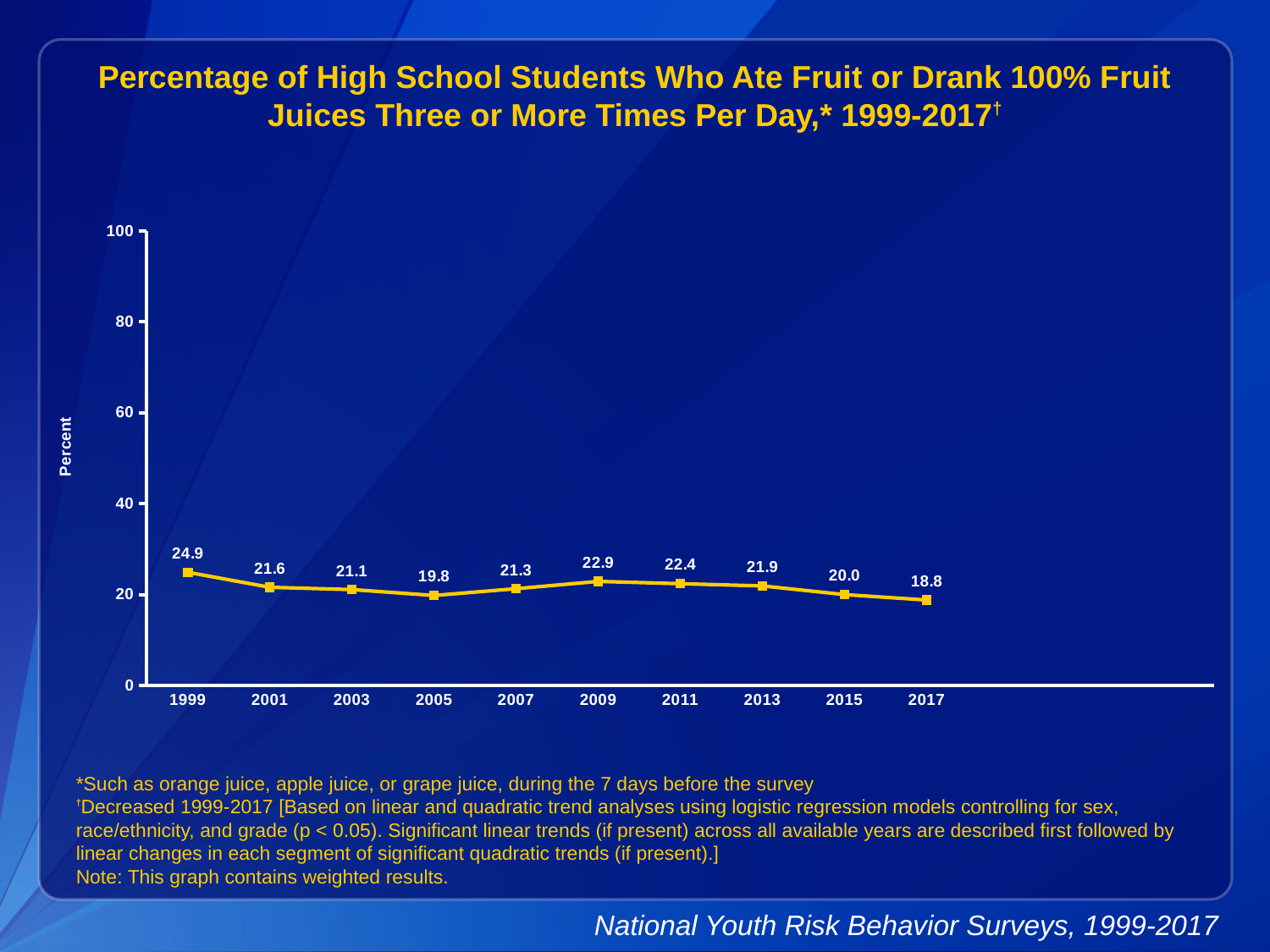
What is the difference between the values for 1999 and 2017? 6.1 Overall, do the values rise or fall from 1999 to 2017? fall What percentage of high school students ate fruit or drank 100% fruit juices three or more times per day in 1999? 24.9 Which year has the lowest value on the chart? 2017 Which year has the highest value on the chart? 1999 What is the label on the vertical axis of the chart? Percent Is the value for 2015 greater or less than 40? less Which year has the larger value, 2005 or 2009? 2009 What kind of chart is shown on the slide? line chart How many years are plotted on the chart? 10 What is the value plotted for 2009? 22.9 What is the value plotted for 2017? 18.8